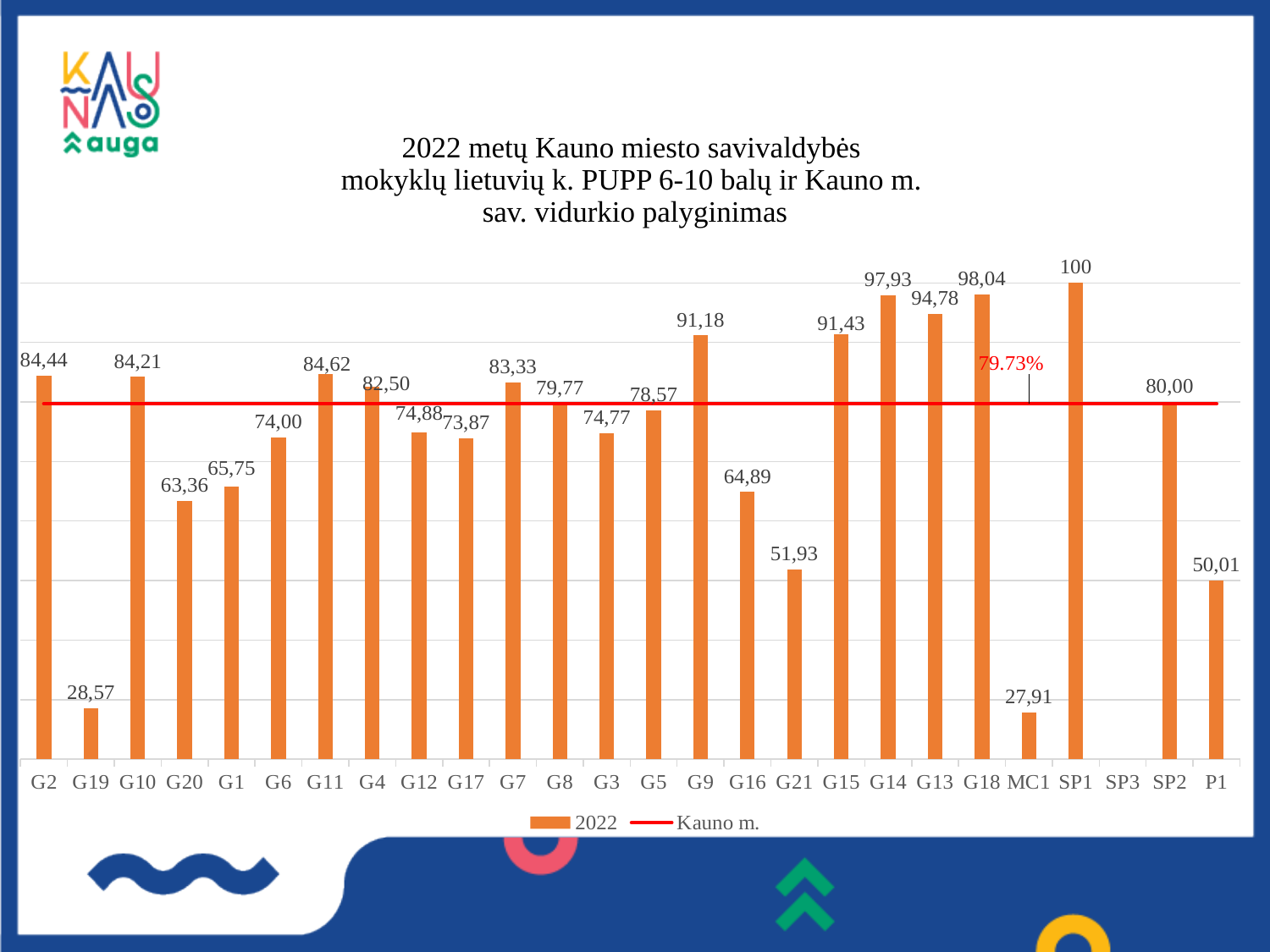
How many series does the legend list? 2 How many categories are shown on the x axis? 26 What is the difference between the values for SP1 and P1? 49,99 Which category has the highest value? SP1 What is the value for MC1? 27,91 What is the value for G9? 91,18 Which category has the lowest value? MC1 Which category on the x axis has no bar plotted? SP3 Which has a larger value, G2 or G10? G2 What value does the red Kauno m. line mark? 79.73% What kind of chart is this? Combination bar and line chart What is the difference between the values for G18 and G14? 0,11